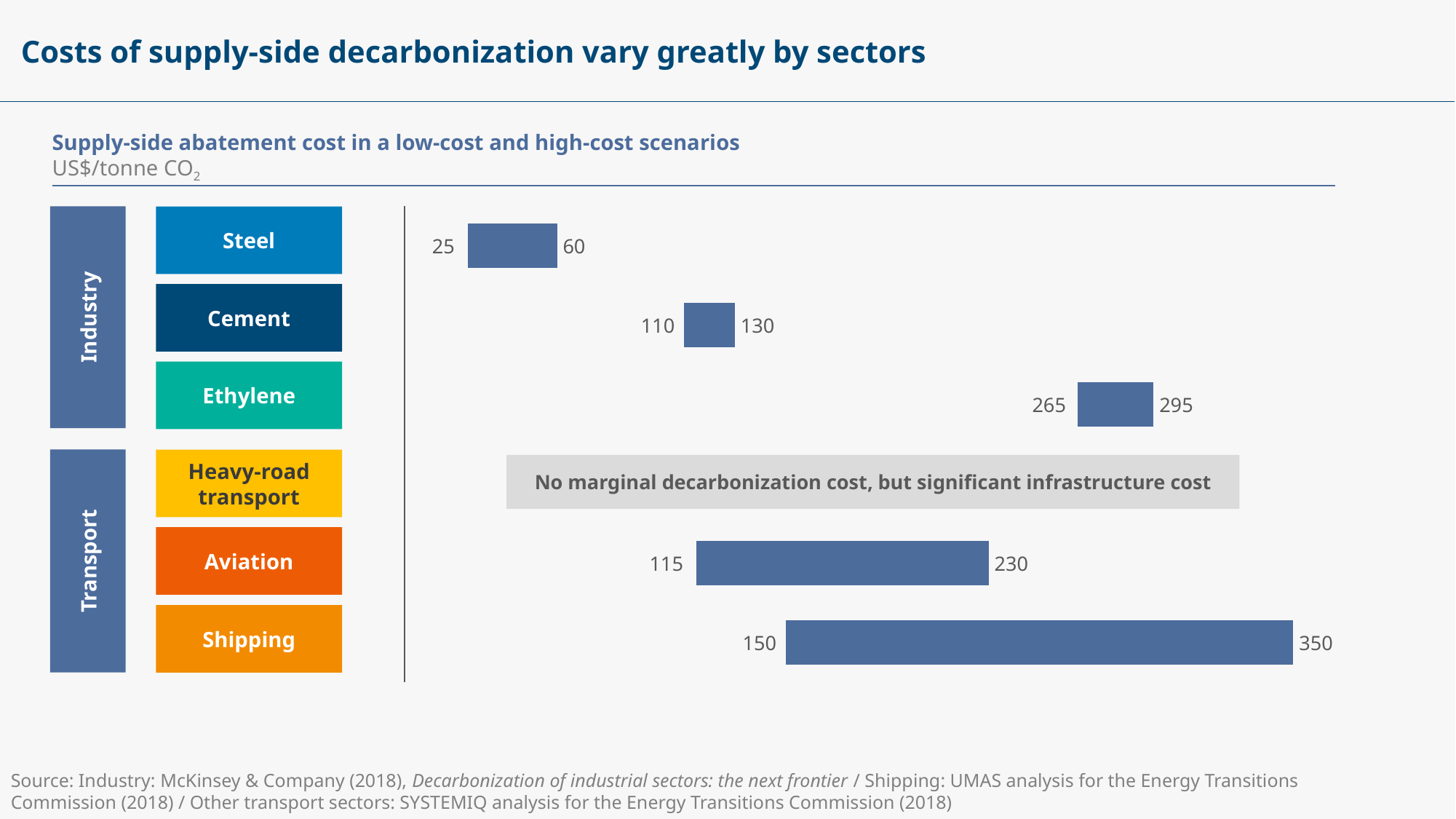
Which has a higher high-cost scenario abatement cost, Aviation or Ethylene? Ethylene What is the difference between the high-cost and low-cost abatement cost for Shipping? 200 What is the high-cost scenario abatement cost for Cement? 130 What is the high-cost scenario abatement cost for Shipping? 350 How many sectors are listed in the chart? 6 Which sector has the highest high-cost scenario abatement cost? Shipping What is the low-cost scenario abatement cost for Steel? 25 What is the difference between the high-cost and low-cost abatement cost for Ethylene? 30 What is the low-cost scenario abatement cost for Aviation? 115 What kind of chart is shown on the slide? Bar chart What is the unit of the abatement cost shown in the chart? US$/tonne CO2